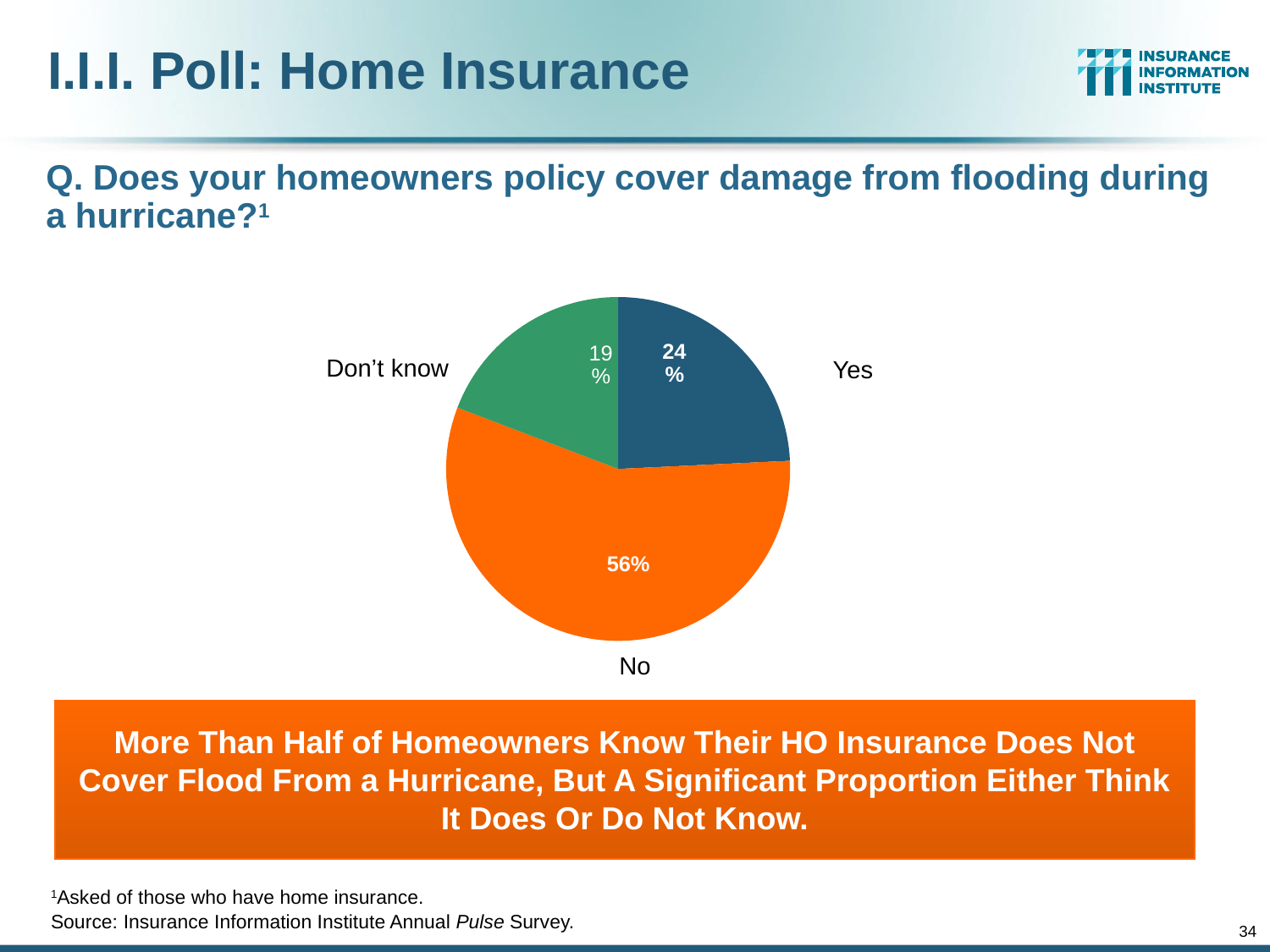
Which response has the largest share of the pie? No What percentage of respondents answered "Yes"? 24% What colour is the "No" slice of the pie? orange Which response has the smallest share of the pie? Don't know What is the difference in percentage points between the "Yes" and "Don't know" responses? 5 How many slices does the pie chart have? 3 What kind of chart is shown on the slide? pie chart What percentage of respondents answered "No"? 56% What is the difference in percentage points between the "No" and "Yes" responses? 32 Which response is larger, "Yes" or "Don't know"? Yes What survey question does the pie chart present responses to? Does your homeowners policy cover damage from flooding during a hurricane? What percentage of respondents answered "Don't know"? 19%